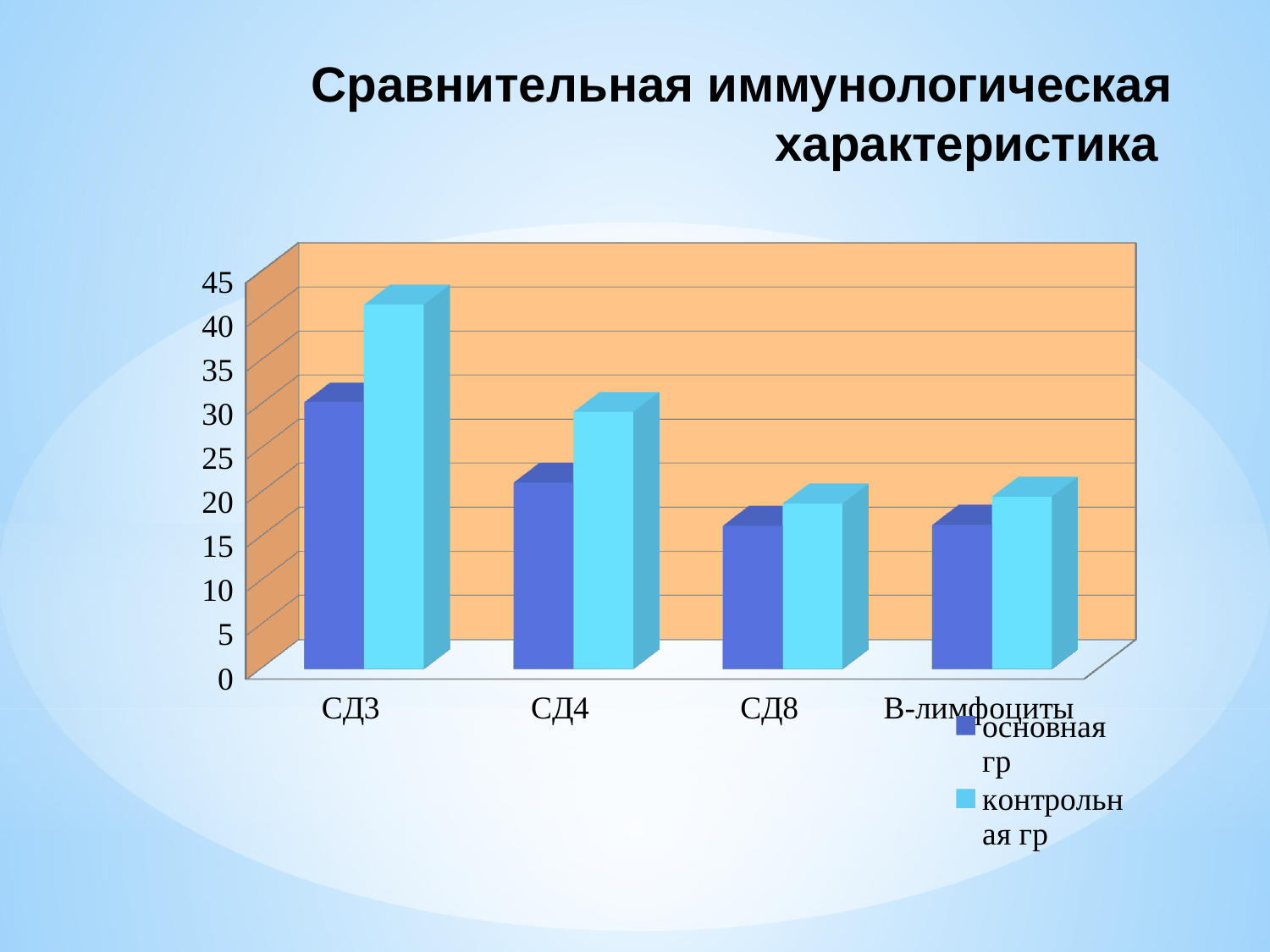
Which series is shown in light blue in the chart? контрольная гр How many series does the chart's legend list? 2 Is the контрольная гр value for В-лимфоциты greater or less than 25? less What kind of chart is shown on the slide? bar chart How many categories are shown on the x axis of the chart? 4 Is the основная гр value for СД3 greater or less than 25? greater Is the основная гр value for СД4 greater or less than 25? less What is the title of the chart on the slide? Сравнительная иммунологическая характеристика For СД3, which is larger: основная гр or контрольная гр? контрольная гр For which category is the основная гр value highest? СД3 For which category is the контрольная гр value highest? СД3